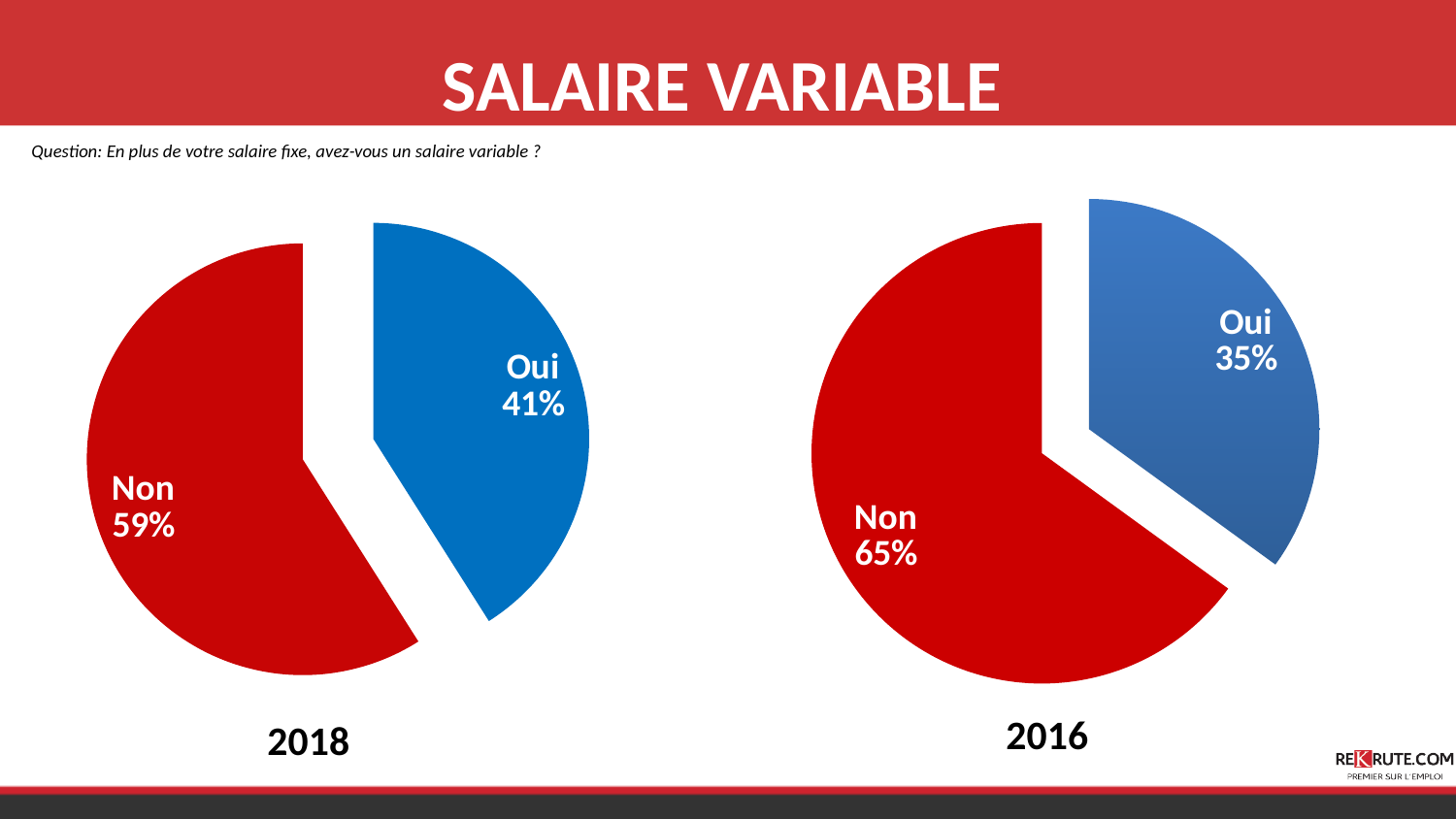
In the 2018 pie chart, which slice is the largest? Non In the 2016 pie chart, what is the share for Non? 65% In the 2018 pie chart, what is the share for Non? 59% What is the difference between the Non and Oui shares in the 2016 pie chart? 30% In the 2016 pie chart, what is the share for Oui? 35% What kind of chart is used for the 2016 data? Pie chart In the 2016 pie chart, which slice is the smallest? Oui In the 2018 pie chart, what is the share for Oui? 41% How many slices does the 2018 pie chart have? 2 In the 2018 pie chart, what colour is the Oui slice? Blue What is the difference between the Oui share in 2018 and the Oui share in 2016? 6% Is the Oui share larger in the 2018 pie chart or the 2016 pie chart? 2018